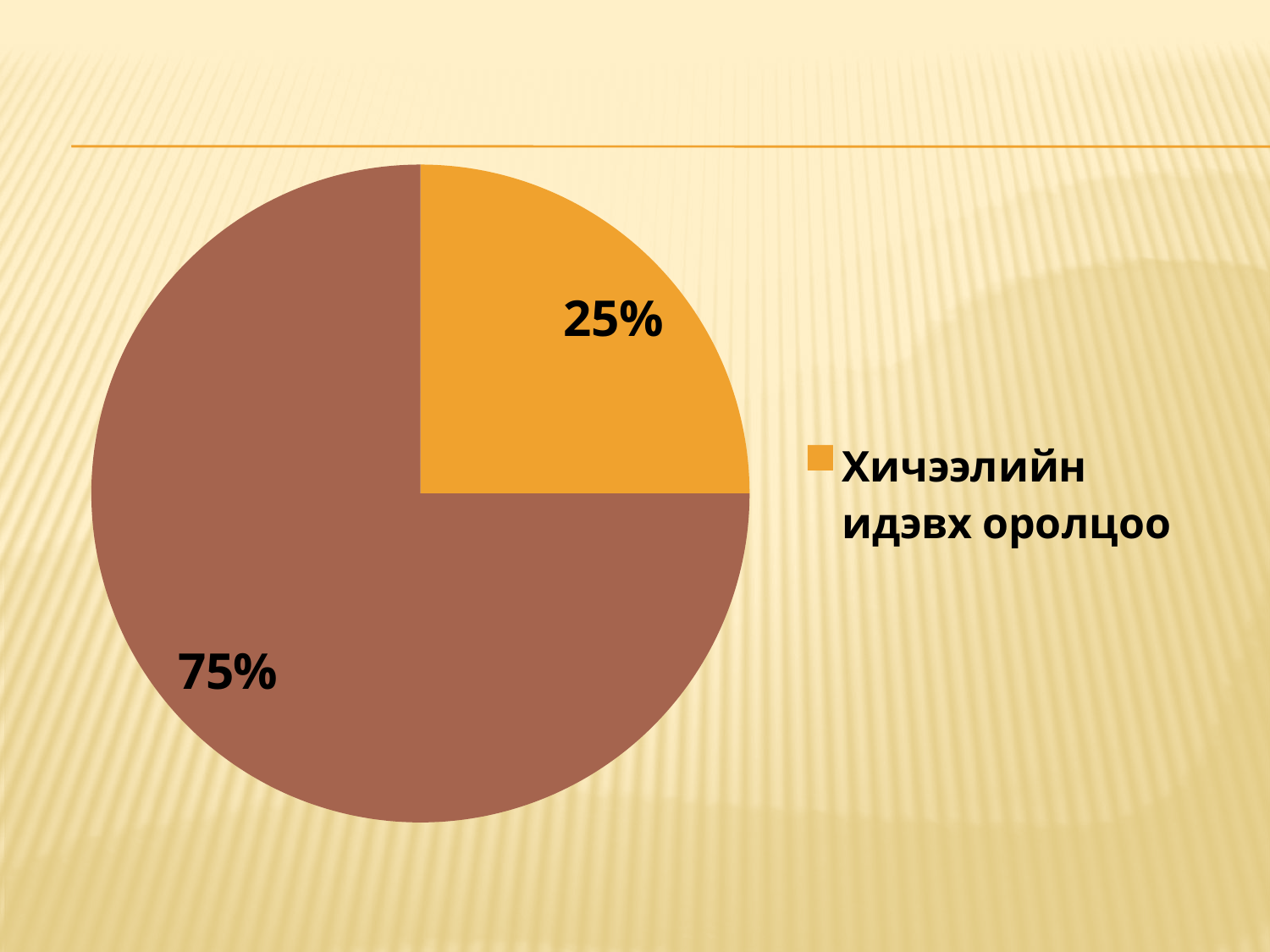
What is the legend entry shown next to the pie chart? Хичээлийн идэвх оролцоо What kind of chart is shown on the slide? pie chart Is the value of the orange slice larger or smaller than the value of the brown slice? smaller What share of the pie does the slice labelled "Хичээлийн идэвх оролцоо" represent? 25% Which slice of the pie chart is the smallest, the orange one or the brown one? the orange one What is the difference in percentage points between the brown slice and the orange slice? 50 percentage points What percentage is shown on the orange slice of the pie chart? 25% Which slice of the pie chart is the largest, the orange one or the brown one? the brown one What colour is the slice labelled "Хичээлийн идэвх оролцоо" in the legend? orange How many entries does the legend of the pie chart list? 1 How many slices does the pie chart have? 2 What percentage is shown on the brown slice of the pie chart? 75%